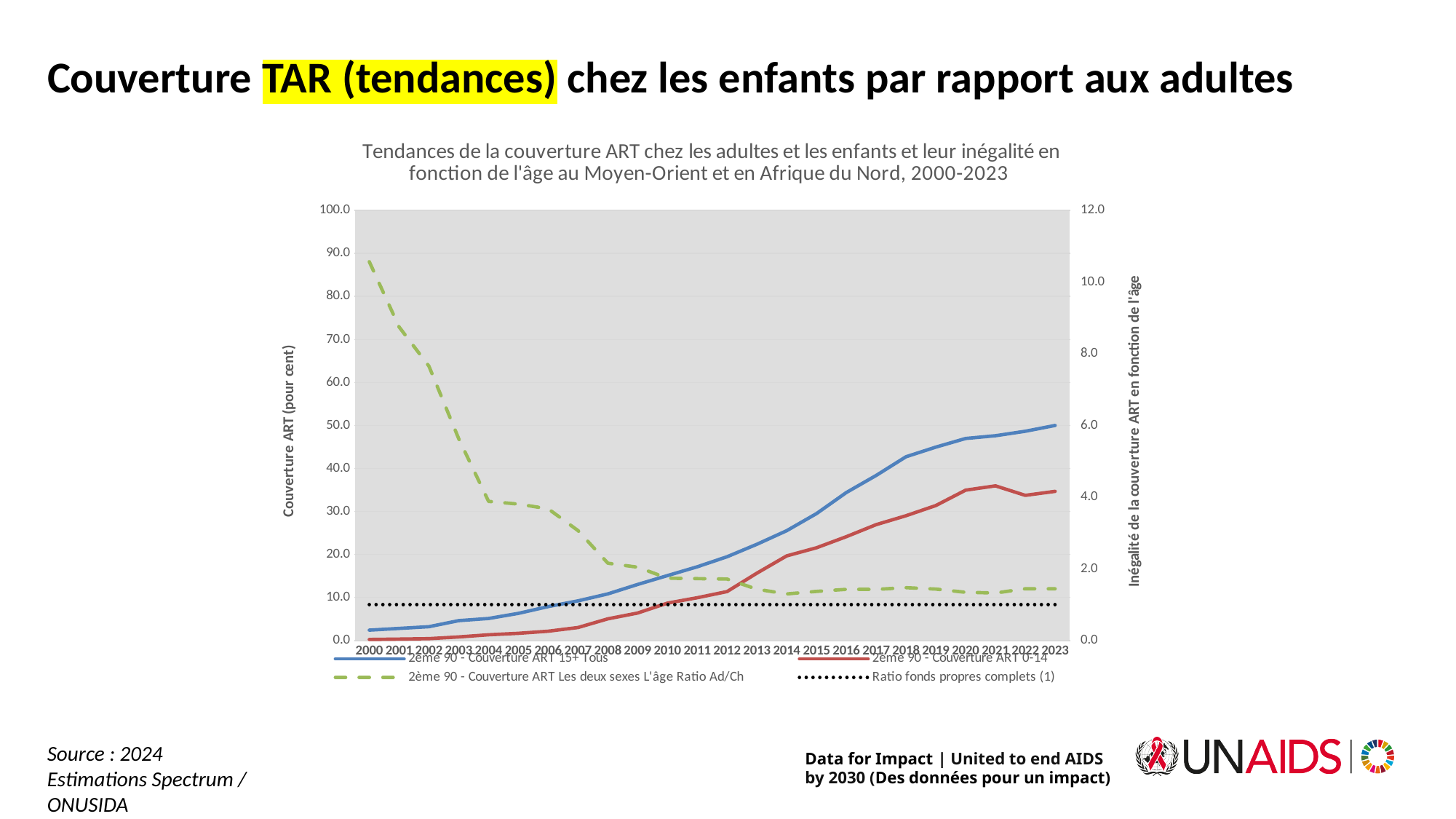
What is the first year shown on the x axis of the chart? 2000 How many years are plotted along the x axis of the chart? 24 How many series does the chart legend list? 4 In which year does '2ème 90 - Couverture ART 15+ Tous' reach its highest value? 2023 Is the value for '2ème 90 - Couverture ART 0-14' in 2023 greater or less than 40.0? less What kind of chart is shown on the slide? line chart Is the value for the dashed 'Ratio Ad/Ch' series in 2000 greater or less than 8.0 on the right axis? greater Does the dashed series '2ème 90 - Couverture ART Les deux sexes L'âge Ratio Ad/Ch' rise or fall from 2000 to 2023? fall Does the series '2ème 90 - Couverture ART 15+ Tous' rise or fall from 2000 to 2023? rise Is the value for '2ème 90 - Couverture ART 15+ Tous' in 2023 greater or less than 40.0? greater In 2023, which is larger: '2ème 90 - Couverture ART 15+ Tous' or '2ème 90 - Couverture ART 0-14'? 2ème 90 - Couverture ART 15+ Tous What is the label of the left vertical axis of the chart? Couverture ART (pour cent)